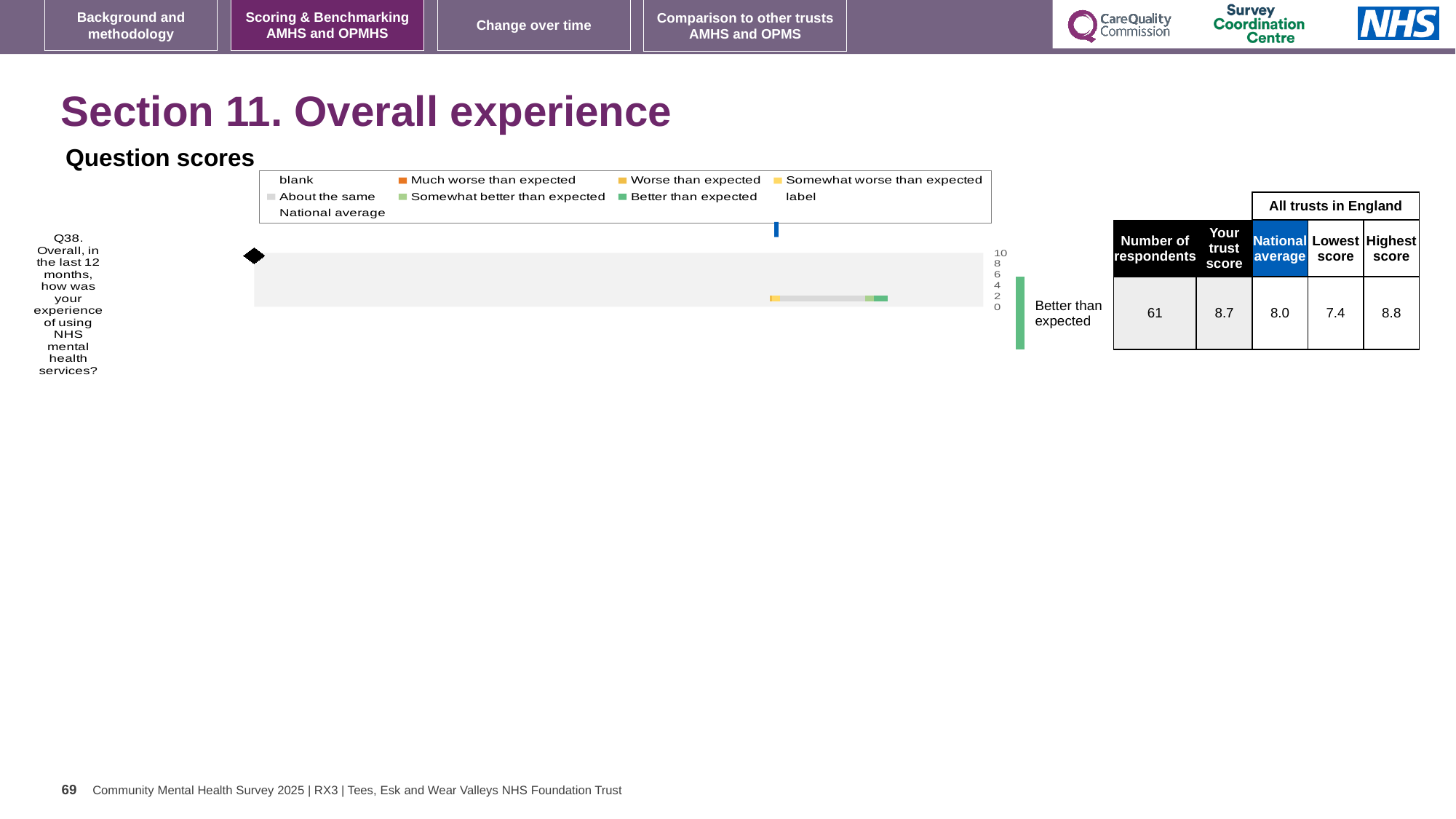
What benchmark category label is shown beside the Q38 bar? Better than expected What is the difference between the highest and lowest scores for Q38 across all trusts in England? 1.4 What kind of chart is used to show the Q38 question score? bar chart What is the trust score for Q38 shown in the table next to the chart? 8.7 How many survey questions are plotted on the Question scores chart? 1 What is the highest score among all trusts in England for Q38? 8.8 How many respondents answered Q38? 61 By how much does the trust score for Q38 exceed the national average? 0.7 What is the national average score for Q38? 8.0 Is the trust score for Q38 greater or less than 8? greater What is the lowest score among all trusts in England for Q38? 7.4 Which is larger for Q38, the trust score or the national average? the trust score